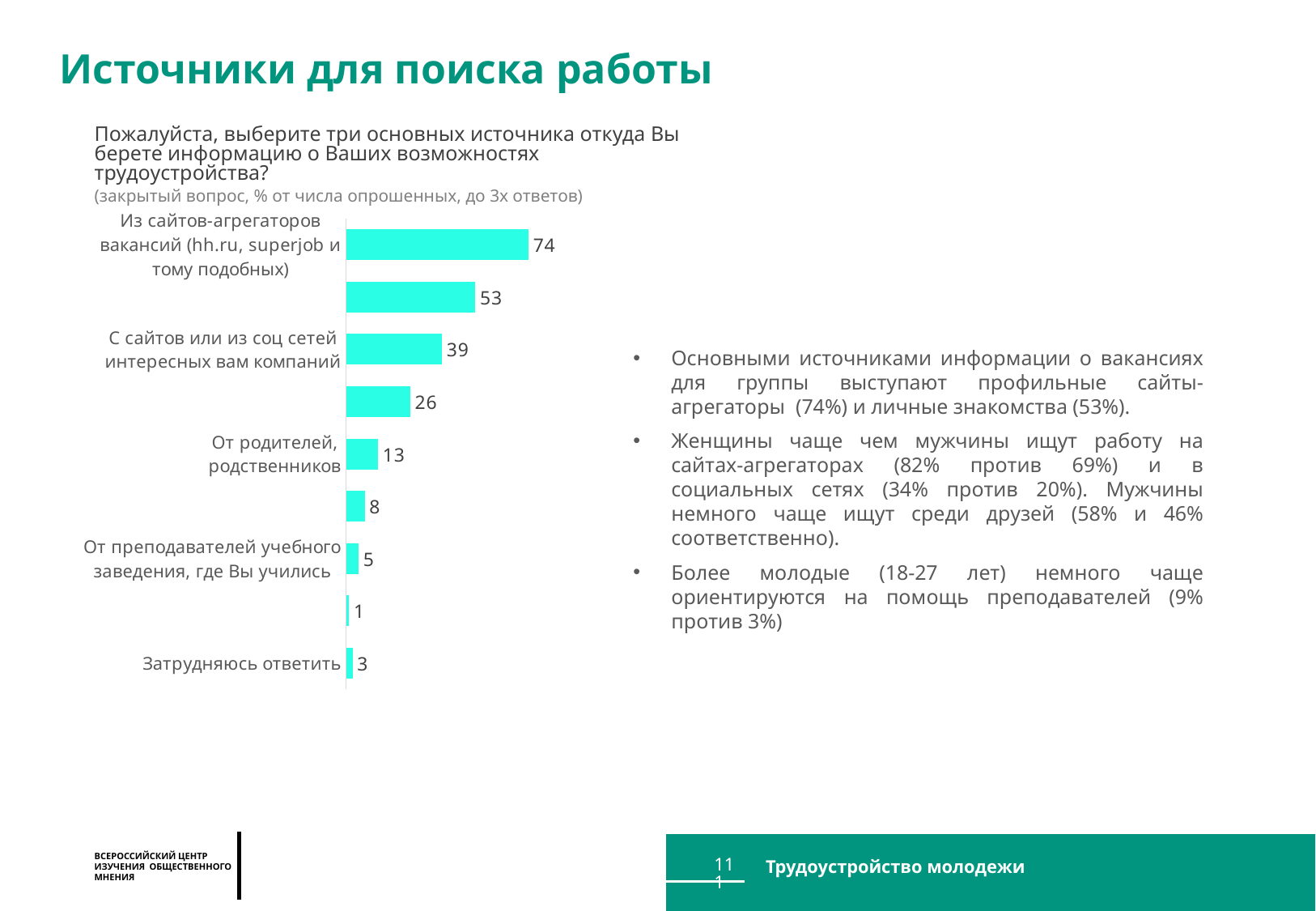
What is the smallest value shown on the chart? 1 What is the value for "От родителей, родственников"? 13 Which is larger: the value for "От родителей, родственников" or for "Затрудняюсь ответить"? От родителей, родственников What is the value for "Из сайтов-агрегаторов вакансий (hh.ru, superjob и тому подобных)"? 74 Which category has the highest value? Из сайтов-агрегаторов вакансий (hh.ru, superjob и тому подобных) What is the title of the slide? Источники для поиска работы How many bars are shown on the chart? 9 What type of chart is shown on the slide? bar chart What is the value for "С сайтов или из соц сетей интересных вам компаний"? 39 What is the difference between the values for "Из сайтов-агрегаторов вакансий" and "С сайтов или из соц сетей интересных вам компаний"? 35 What is the value for "От преподавателей учебного заведения, где Вы учились"? 5 What is the value for "Затрудняюсь ответить"? 3